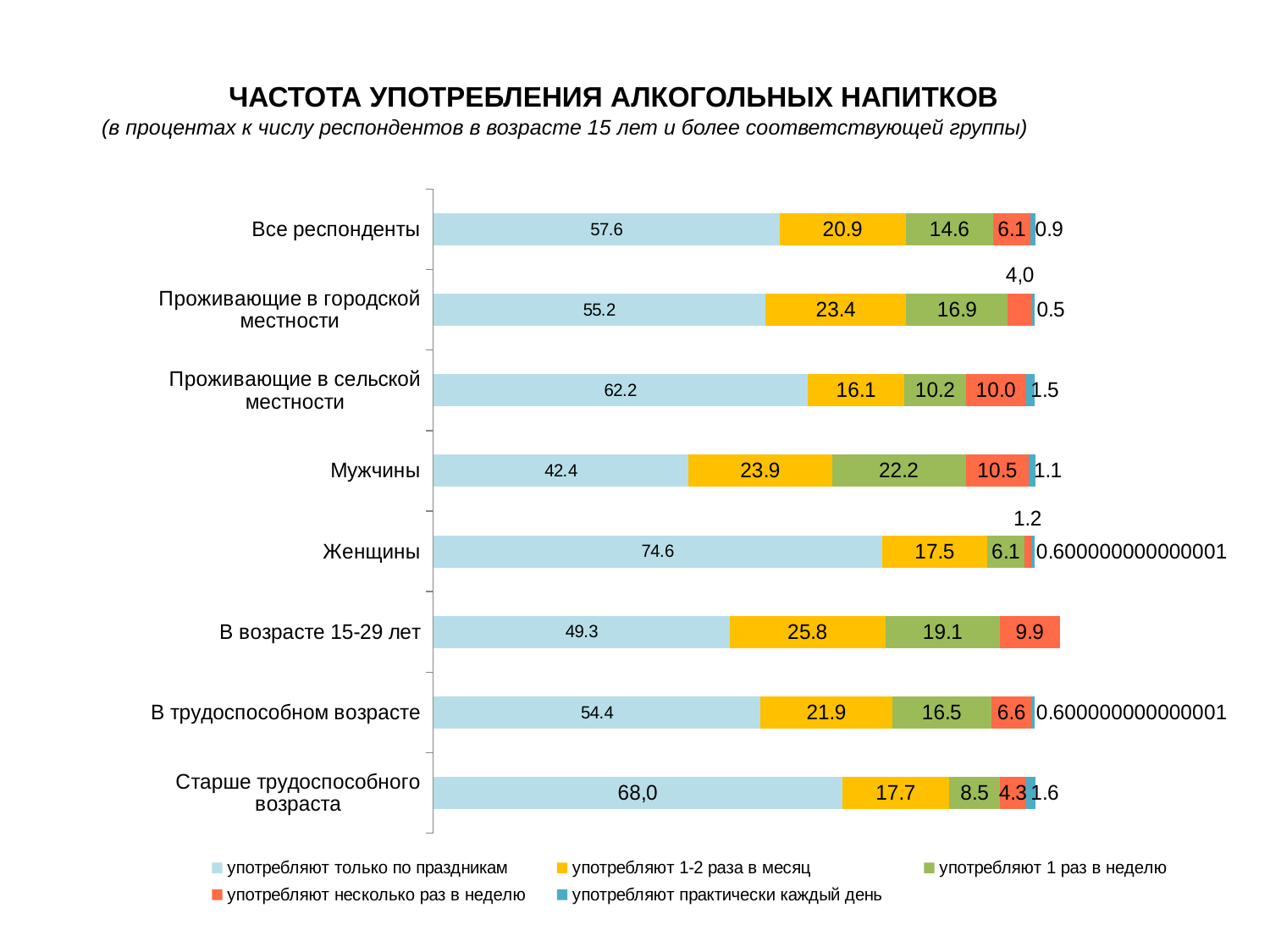
Which category has the lowest value for 'употребляют только по праздникам'? Мужчины What kind of chart is shown on the slide? Stacked bar chart What is the difference between the 'употребляют только по праздникам' values for 'Женщины' and 'Мужчины'? 32.2 How many categories (groups of respondents) are shown on the chart? 8 Which category has the highest value for 'употребляют только по праздникам'? Женщины What is the value of 'употребляют 1-2 раза в месяц' for 'В возрасте 15-29 лет'? 25.8 What is the value of 'употребляют только по праздникам' for 'Мужчины'? 42.4 What is the total of the stacked bar for 'Проживающие в сельской местности'? 100.0 How many series does the legend list? 5 What is the value of 'употребляют 1 раз в неделю' for 'Проживающие в городской местности'? 16.9 What is the value of 'употребляют практически каждый день' for 'Старше трудоспособного возраста'? 1.6 Which is larger: the 'употребляют несколько раз в неделю' value for 'Мужчины' or for 'Женщины'? Мужчины